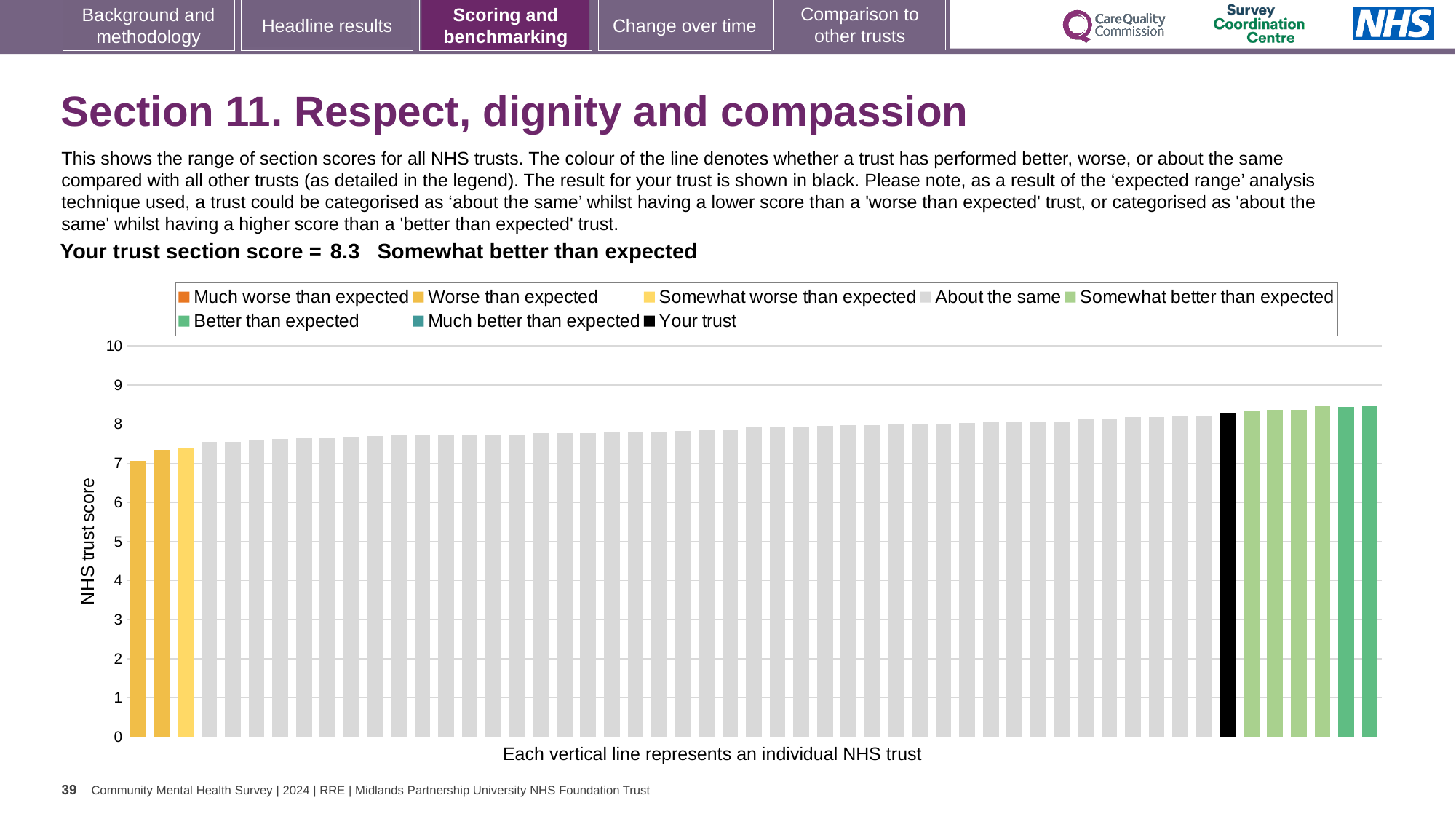
Do the bar values rise or fall from left to right across the chart? rise What is the section score for your trust shown on the slide? 8.3 What colour is the bar representing your trust? black What is the label on the vertical axis of the chart? NHS trust score Is the value for your trust greater or less than 8? greater Is the value of the highest bar in the chart greater or less than 9? less How many trusts are shown as 'Somewhat worse than expected' in the chart? 1 How many entries does the chart legend list? 8 Is the value of the lowest bar in the chart greater or less than 8? less How many trusts are shown as 'Worse than expected' in the chart? 2 What kind of chart is shown on the slide? bar chart